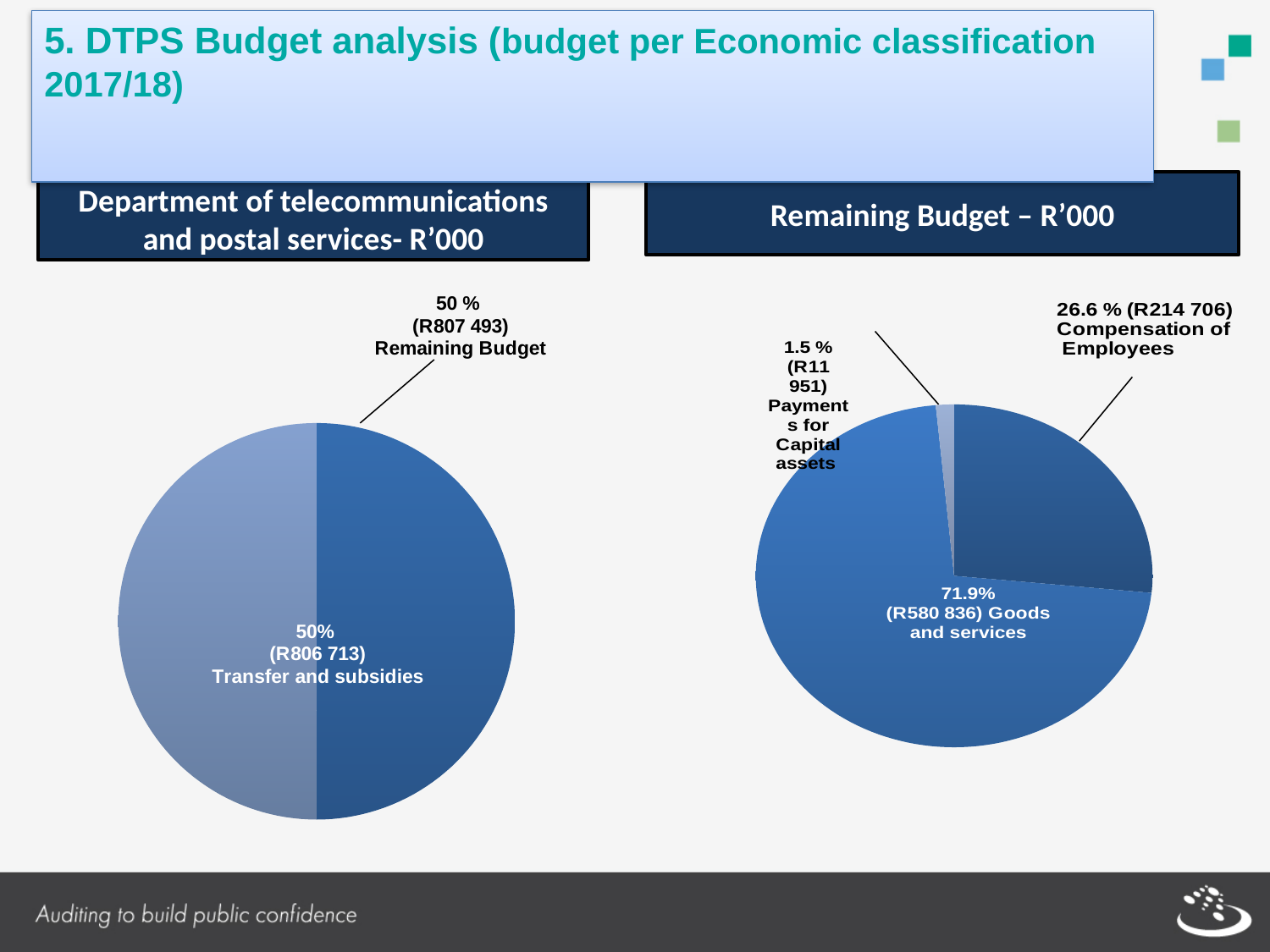
In the 'Remaining Budget – R'000' chart, what is the difference between the Goods and services value and the Compensation of Employees value? R366 130 In the 'Remaining Budget – R'000' chart, how many slices does the pie have? 3 In the 'Remaining Budget – R'000' chart, what is the value for Compensation of Employees? R214 706 In the 'Department of telecommunications and postal services- R'000' chart, what is the value for Transfer and subsidies? R806 713 In the 'Remaining Budget – R'000' chart, what is the value for Goods and services? R580 836 In the 'Remaining Budget – R'000' chart, what is the value for Payments for Capital assets? R11 951 In the 'Department of telecommunications and postal services- R'000' chart, what is the value for Remaining Budget? R807 493 What type of chart is used on the left side of the slide, under 'Department of telecommunications and postal services- R'000'? Pie chart In the 'Department of telecommunications and postal services- R'000' chart, what share of the pie is Transfer and subsidies? 50% In the 'Remaining Budget – R'000' chart, which category has the largest slice? Goods and services In the 'Remaining Budget – R'000' chart, which category has the smallest slice? Payments for Capital assets In the 'Remaining Budget – R'000' chart, what share of the pie is Compensation of Employees? 26.6 %